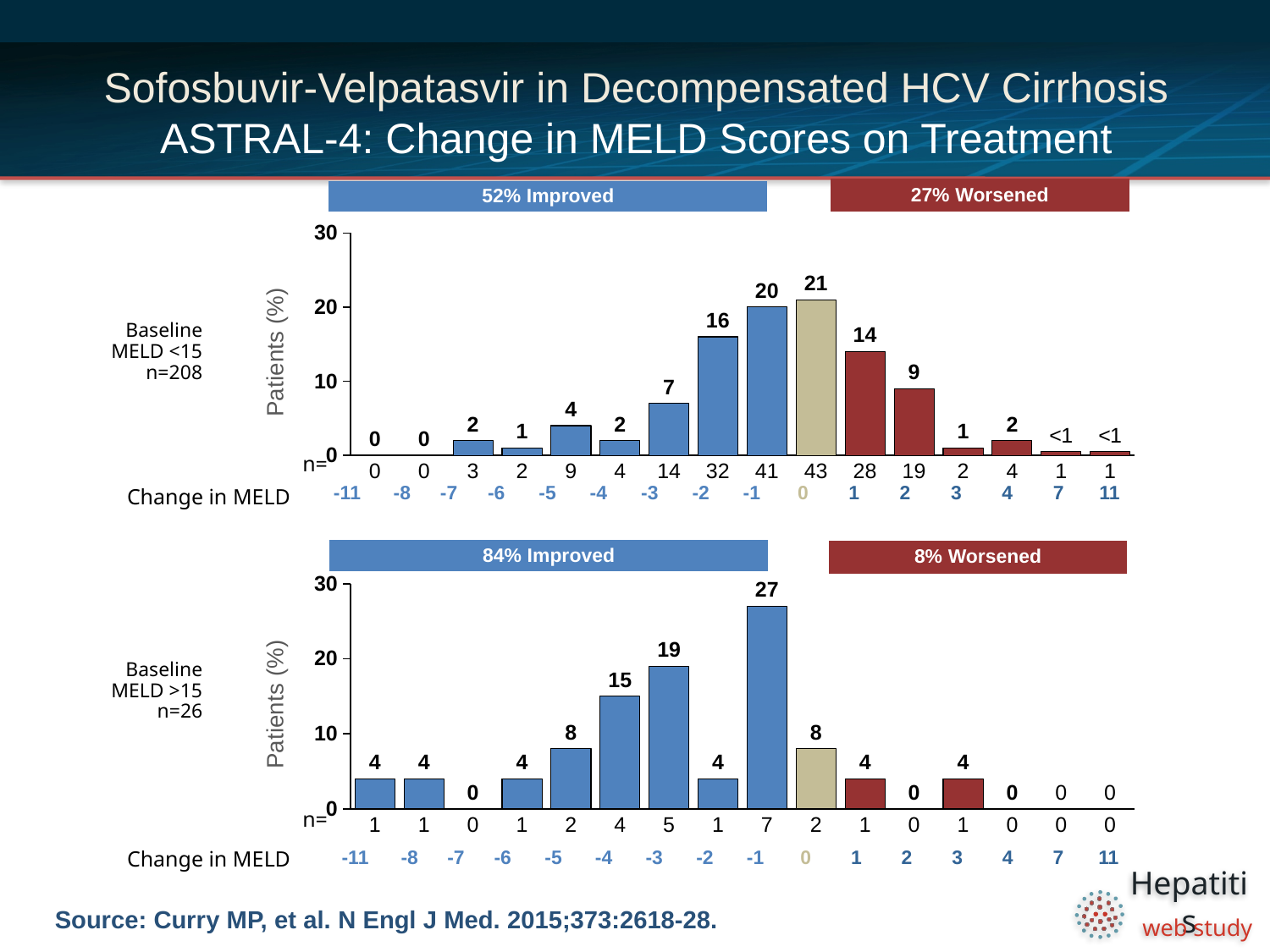
In the bottom chart (Baseline MELD >15), which has a higher percentage of patients: a change in MELD of -3 or a change of -5? -3 According to the banner above the bottom chart (Baseline MELD >15), what percentage of patients improved? 84% Improved In the bottom chart (Baseline MELD >15), which change in MELD has the highest percentage of patients? -1 In the bottom chart (Baseline MELD >15), what percentage of patients had a change in MELD of -1? 27 In the top chart (Baseline MELD <15), what percentage of patients had a change in MELD of -2? 16 In the top chart (Baseline MELD <15), what is the difference in percentage of patients between a change in MELD of -1 and a change of +1? 6 In the top chart (Baseline MELD <15), is the value for a change in MELD of +2 greater or less than 10? less How many change-in-MELD categories are shown on the x axis of the top chart (Baseline MELD <15)? 16 In the top chart (Baseline MELD <15), which change in MELD has the highest percentage of patients? 0 In the top chart (Baseline MELD <15), what percentage of patients had a change in MELD of 0? 21 What type of chart is the bottom chart (Baseline MELD >15)? bar chart In the bottom chart (Baseline MELD >15), what percentage of patients had a change in MELD of -4? 15